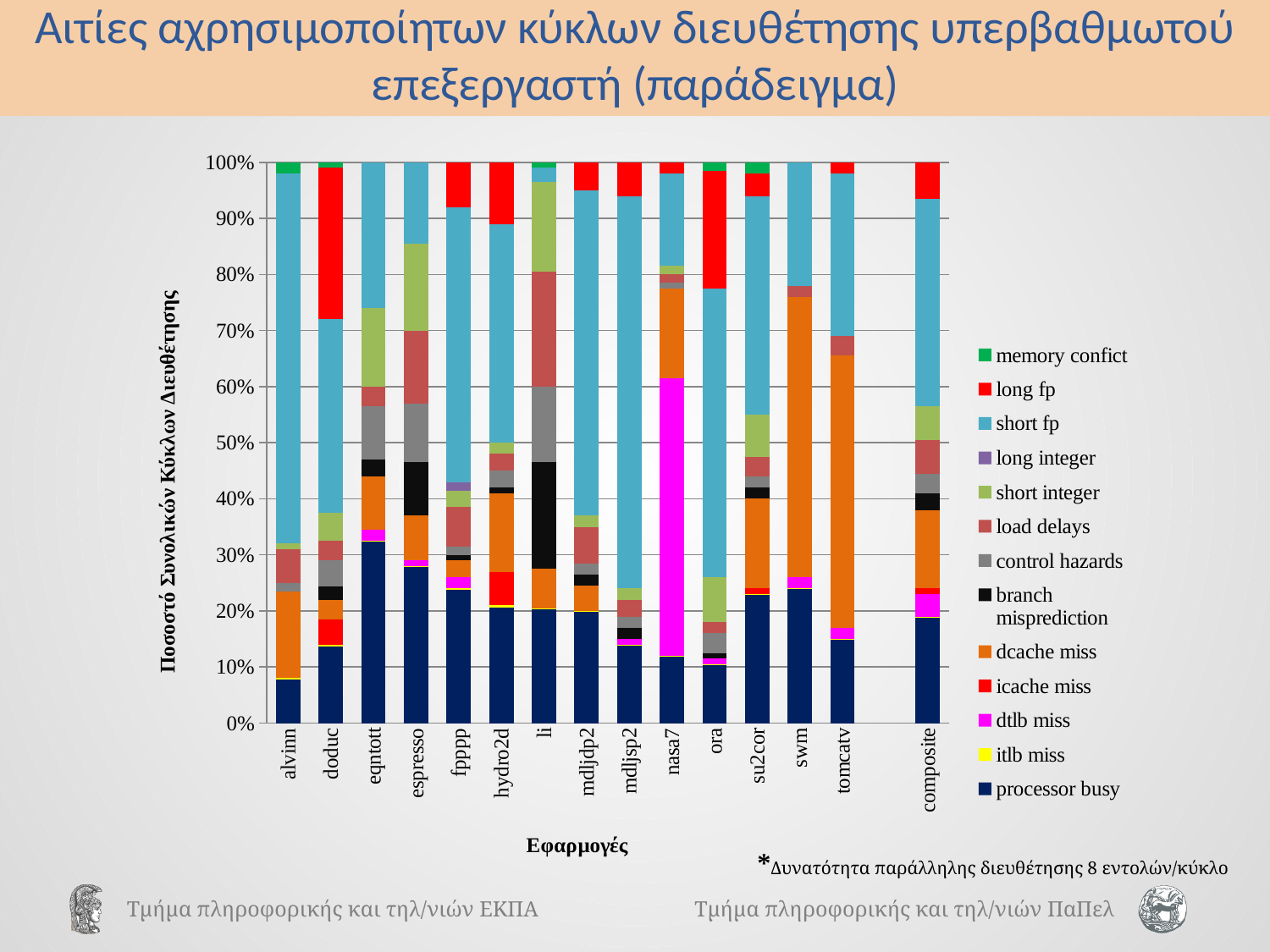
Which is larger, the 'processor busy' segment for eqntott or for alvinn? eqntott What does each full stacked bar add up to? 100% How many series does the legend list? 13 What kind of chart is shown on the slide? stacked bar chart Is the 'processor busy' value for alvinn greater or less than 10%? less Is the 'processor busy' value for swm greater or less than 20%? greater Is the 'processor busy' value for eqntott greater or less than 30%? greater What is the x-axis title of the chart? Εφαρμογές Which application has by far the largest 'dtlb miss' segment? nasa7 Which series is shown in dark blue at the bottom of each bar? processor busy How many applications (categories) are plotted along the x axis? 15 Which application has the largest 'processor busy' segment? eqntott